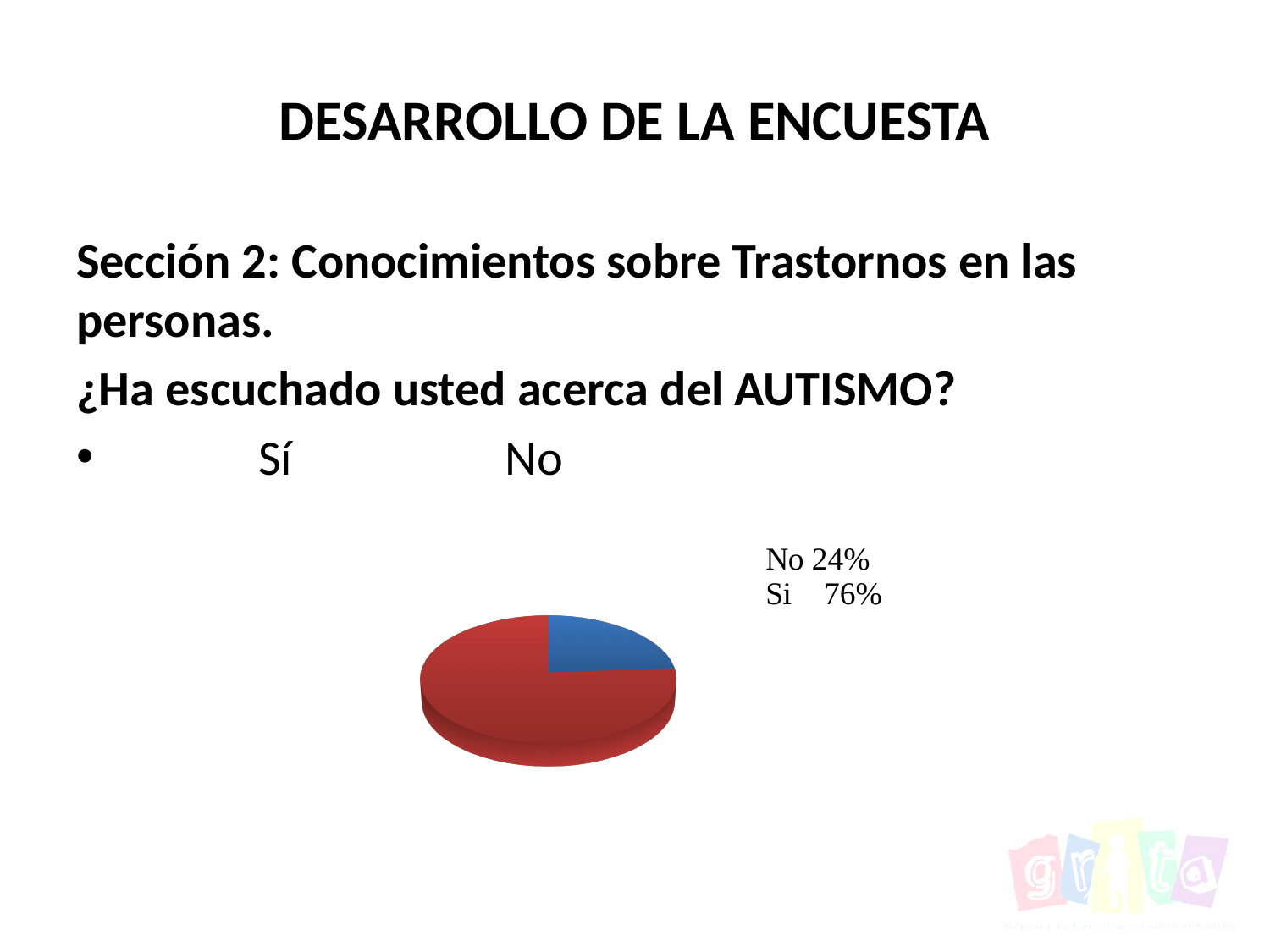
What percentage of respondents answered "Si" in the pie chart? 76% Which response does the red slice of the pie chart represent? Si Which response has the smallest slice of the pie chart? No What kind of chart is shown on the slide? Pie chart How many slices does the pie chart have? 2 What share of the pie does the "Si" slice represent? 76% Which response has the largest slice of the pie chart? Si What share of the pie does the "No" slice represent? 24% What is the difference in percentage points between the "Si" and "No" slices? 52% What percentage of respondents answered "No" in the pie chart? 24% Which is larger in the pie chart, the "Si" slice or the "No" slice? Si Which response does the blue slice of the pie chart represent? No